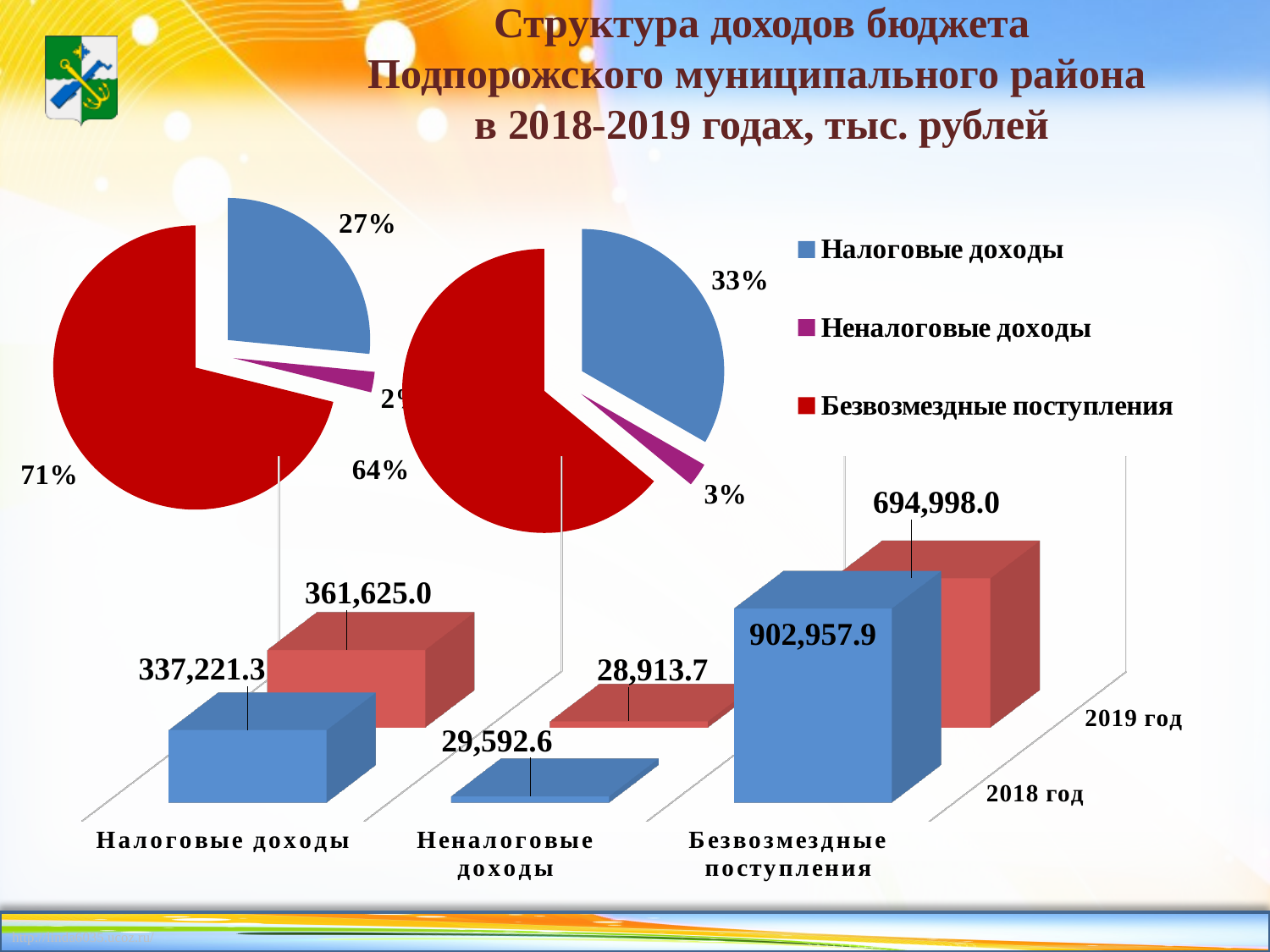
In the bar chart, what is the value for Налоговые доходы in 2018 год? 337,221.3 What kind of chart is shown at the bottom of the slide? Bar chart In the left pie chart, what share does Безвозмездные поступления have? 71% In the bar chart, what is the difference between the 2018 год and 2019 год values for Безвозмездные поступления? 207,959.9 In the bar chart, how many categories are shown on the x axis? 3 In the bar chart, which is larger for Налоговые доходы: the 2018 год value or the 2019 год value? 2019 год In the right pie chart, what share does Налоговые доходы have? 33% In the bar chart, which category has the highest value in 2018 год? Безвозмездные поступления In the bar chart, what is the value for Безвозмездные поступления in 2019 год? 694,998.0 In the bar chart, what is the value for Неналоговые доходы in 2018 год? 29,592.6 How many series does the legend list? 3 In the bar chart, which category has the lowest value in 2019 год? Неналоговые доходы